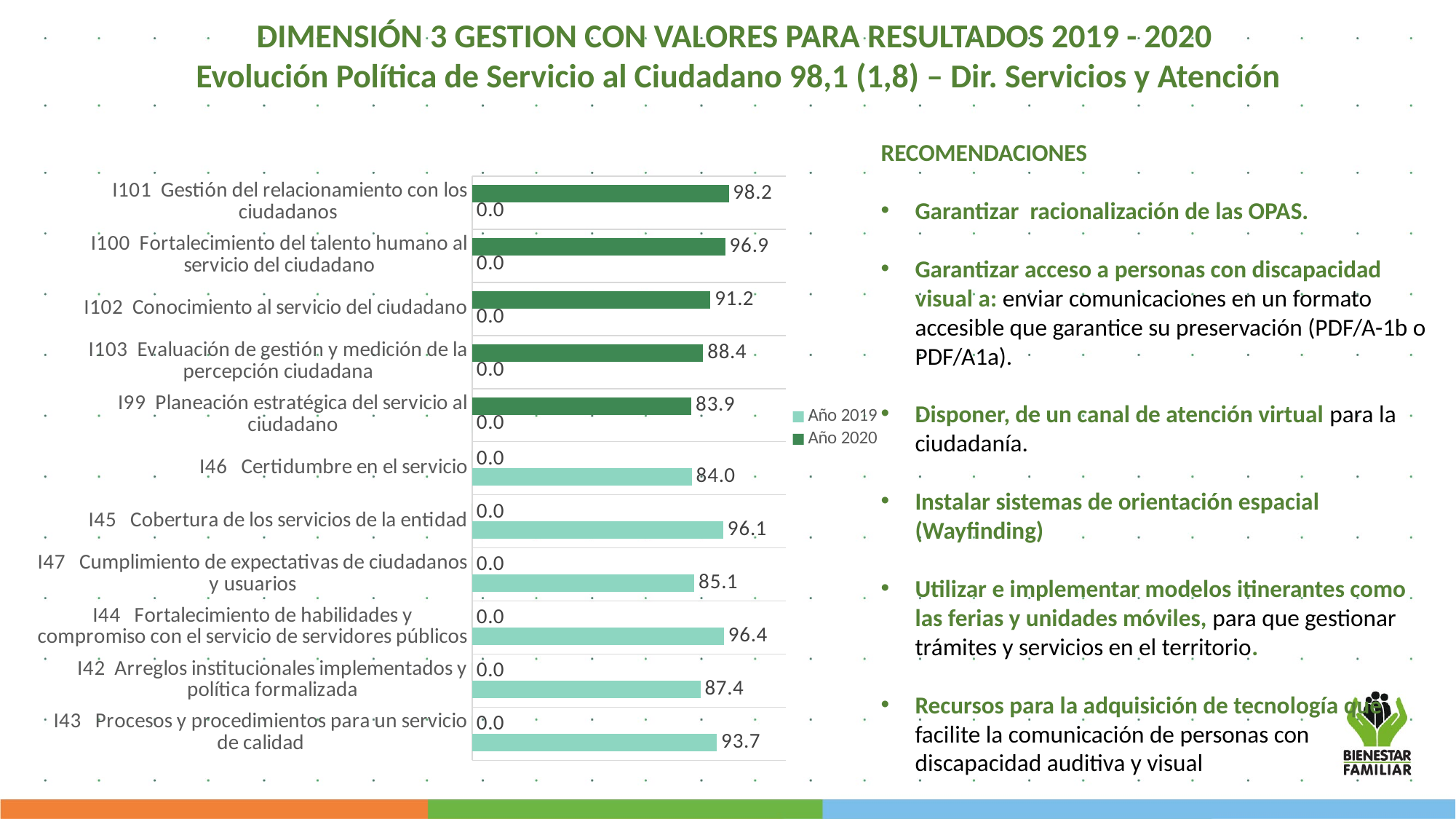
Which category has the highest Año 2020 value? I101 Gestión del relacionamiento con los ciudadanos What kind of chart is shown on the slide? Bar chart What is the Año 2020 value for I101 Gestión del relacionamiento con los ciudadanos? 98.2 Which category has the lowest non-zero Año 2019 value? I46 Certidumbre en el servicio What is the Año 2020 value for I99 Planeación estratégica del servicio al ciudadano? 83.9 How many series does the chart legend list? 2 What is the Año 2019 value for I46 Certidumbre en el servicio? 84.0 What is the Año 2019 value for I43 Procesos y procedimientos para un servicio de calidad? 93.7 How many categories are plotted in the chart? 11 Which series is shown in dark green in the chart legend? Año 2020 What is the difference between the Año 2020 value for I100 Fortalecimiento del talento humano al servicio del ciudadano and the Año 2020 value for I102 Conocimiento al servicio del ciudadano? 5.7 Which is larger: the Año 2019 value for I45 Cobertura de los servicios de la entidad or the Año 2019 value for I42 Arreglos institucionales implementados y política formalizada? I45 Cobertura de los servicios de la entidad